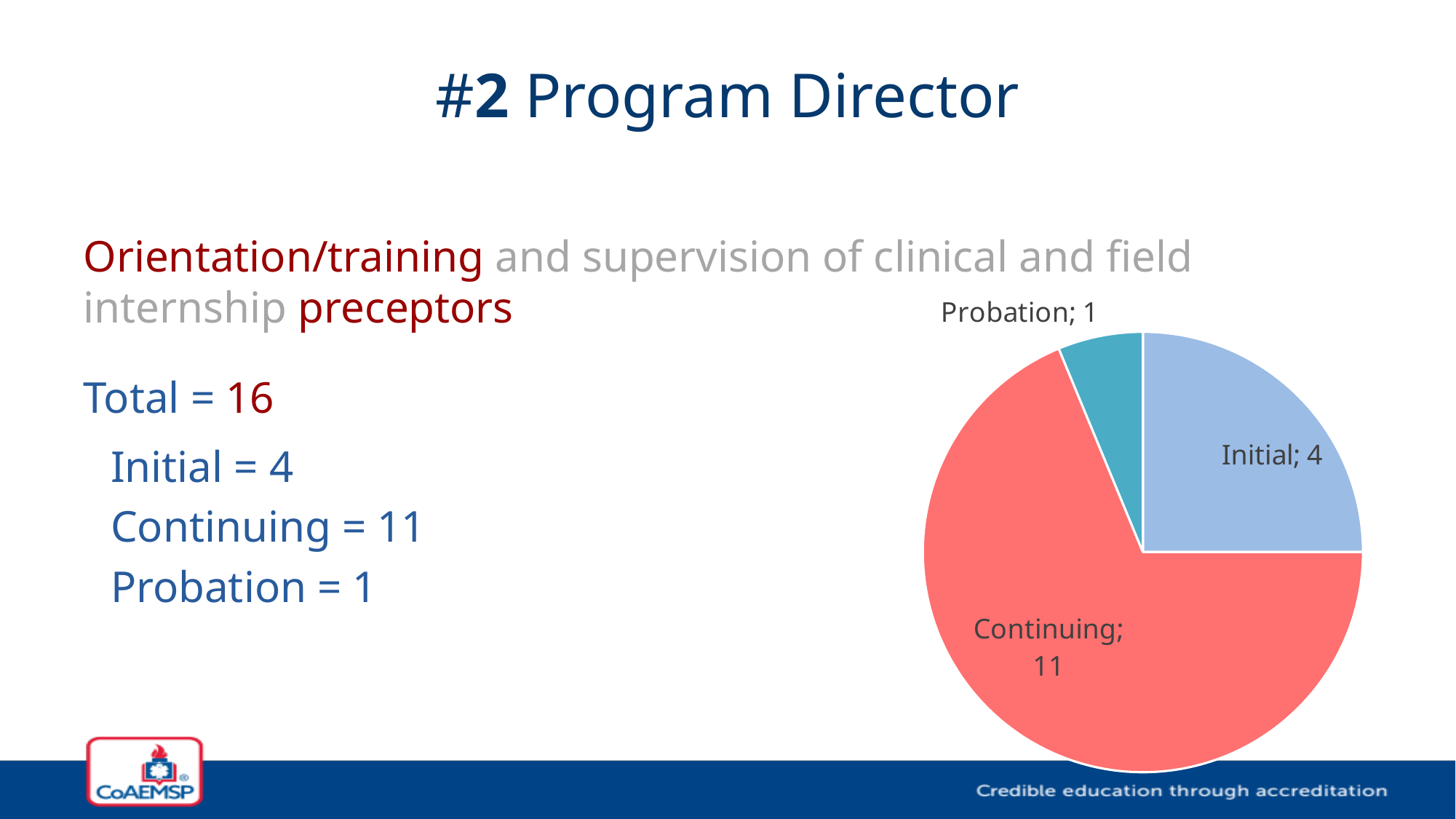
What share of the pie does Initial represent? 25% What is the difference between the Continuing and Initial values? 7 Which category has the largest slice in the pie chart? Continuing What is the value for Continuing in the pie chart? 11 How many slices does the pie chart have? 3 Which is larger, Initial or Probation? Initial What colour is the Continuing slice in the pie chart? red What is the value for Initial in the pie chart? 4 Which category has the smallest slice in the pie chart? Probation What is the value for Probation in the pie chart? 1 What is the total of all slices in the pie chart? 16 What type of chart is shown on the slide? pie chart